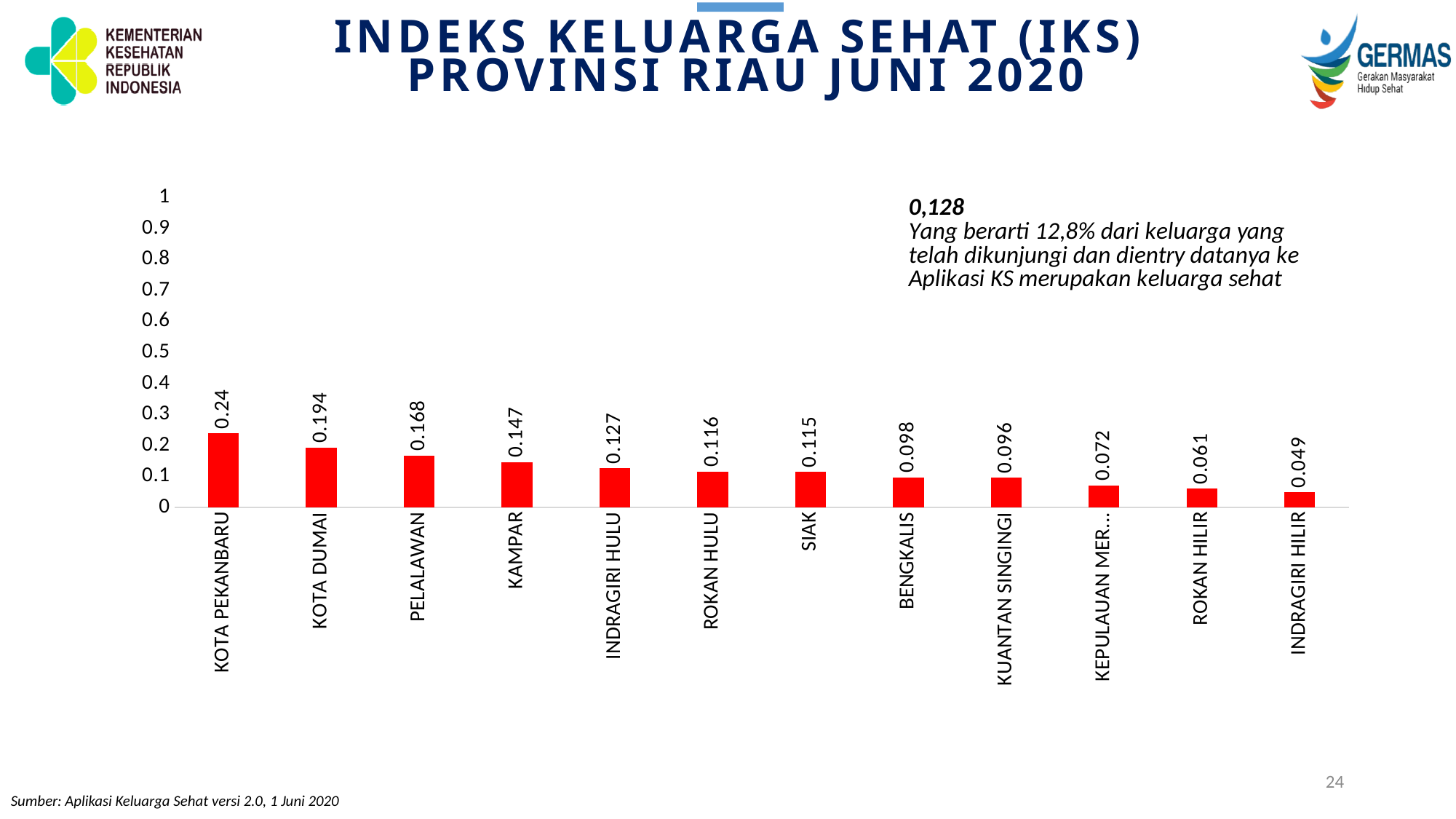
Is the value for INDRAGIRI HULU greater or less than 0.2? less What is the IKS value for BENGKALIS? 0.098 What is the IKS value for KAMPAR? 0.147 What kind of chart is shown on the slide? bar chart Which category has the lowest IKS value? INDRAGIRI HILIR What is the difference between the IKS values of KOTA PEKANBARU and KOTA DUMAI? 0.046 Which category has the highest IKS value? KOTA PEKANBARU What is the IKS value for ROKAN HILIR? 0.061 What is the IKS value for KOTA PEKANBARU? 0.24 Which has a larger IKS value, PELALAWAN or SIAK? PELALAWAN How many categories are shown in the chart? 12 Do the values rise or fall from left to right along the x axis? fall